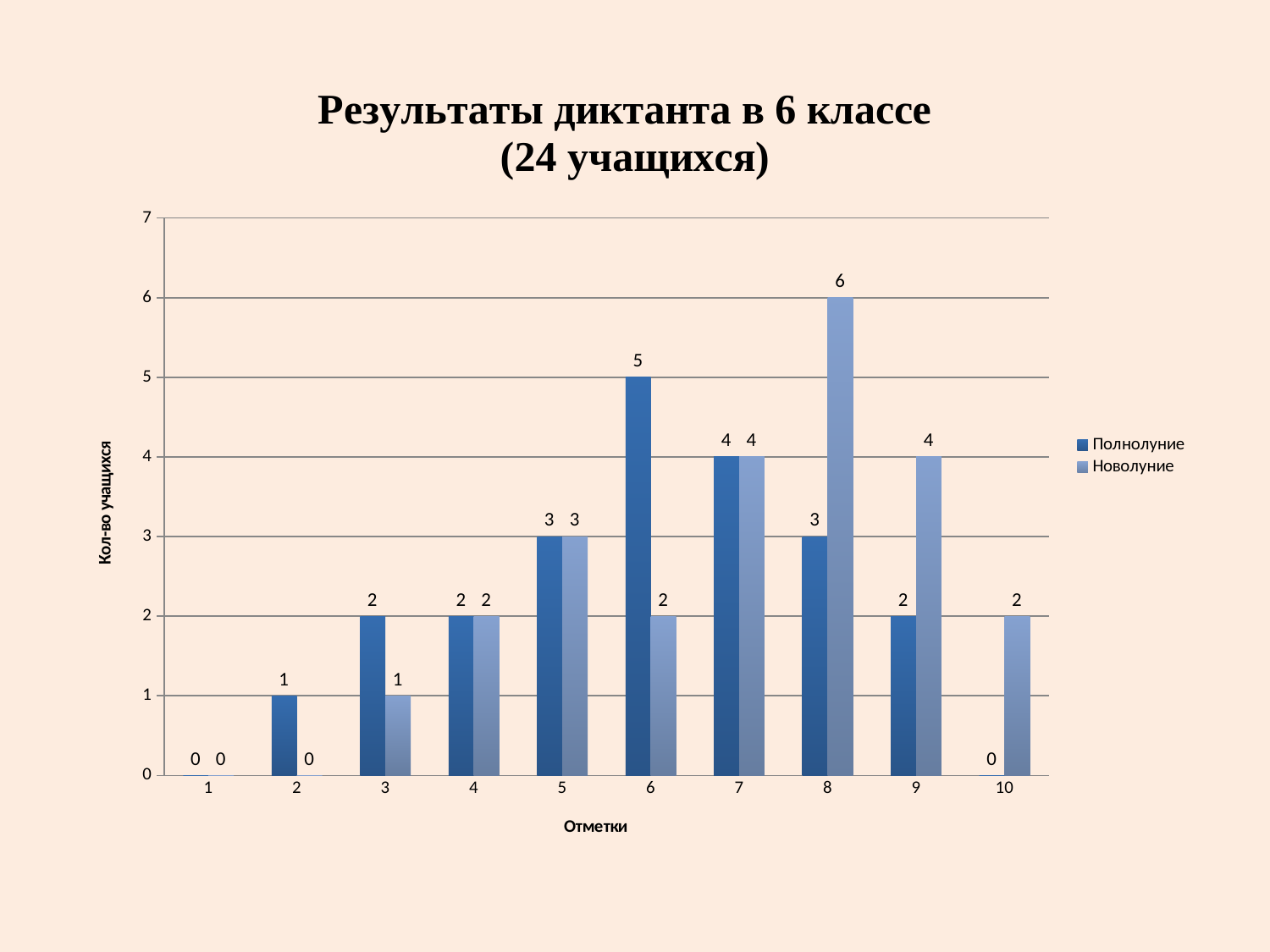
What is the title of the chart? Результаты диктанта в 6 классе (24 учащихся) How many series does the legend list? 2 What is the difference between the Новолуние and Полнолуние values at отметка 8? 3 How many categories (отметки) are shown on the x axis? 10 What is the value for Полнолуние at отметка 2? 1 What is the value for Новолуние at отметка 8? 6 At which отметка is the Новолуние value highest? 8 What is the value for Полнолуние at отметка 6? 5 What type of chart is shown on the slide? bar chart What is the value for Новолуние at отметка 10? 2 At which отметка is the Полнолуние value highest? 6 Which series has the larger value at отметка 9, Полнолуние or Новолуние? Новолуние